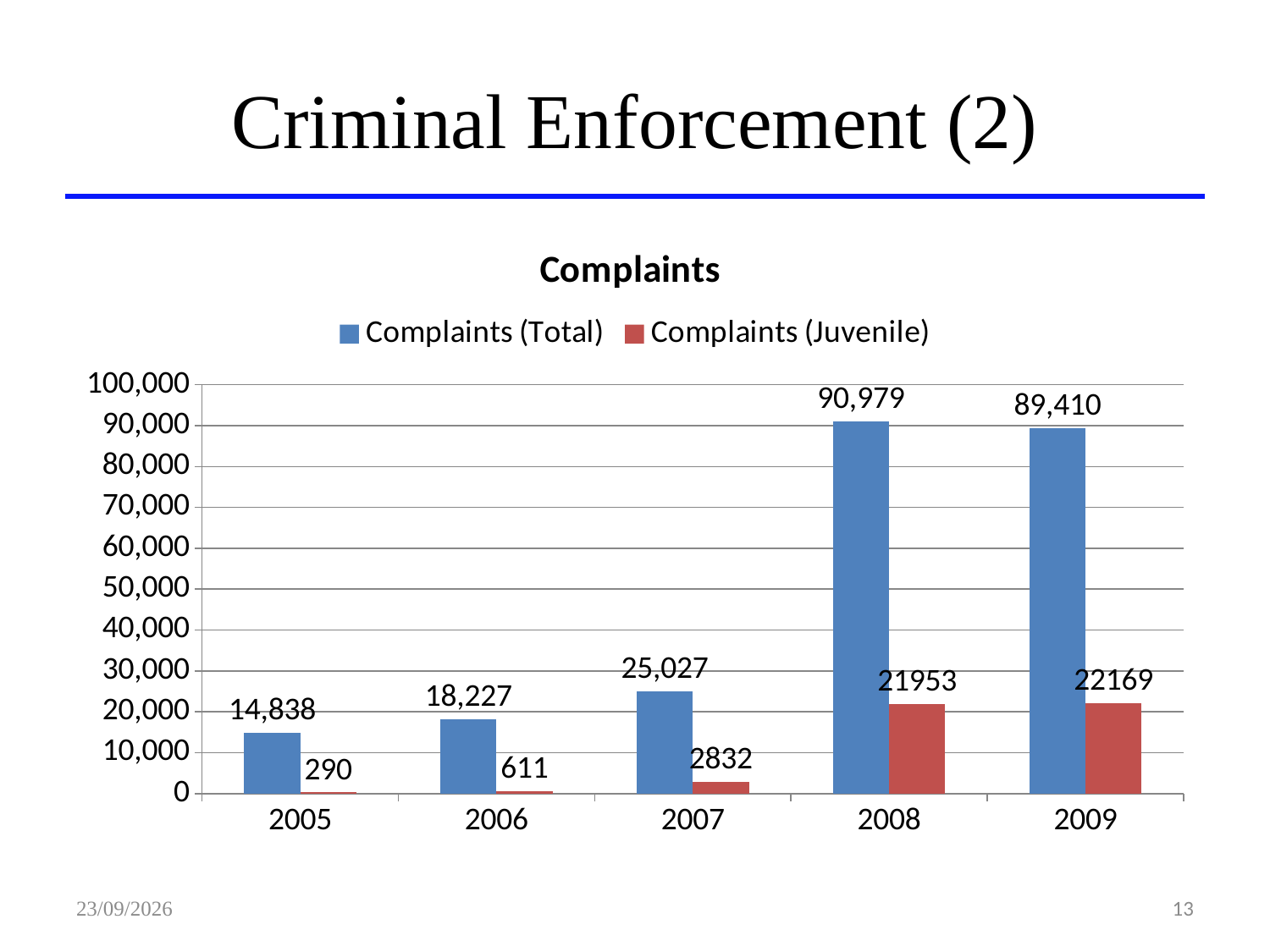
What is the value of Complaints (Total) for 2005? 14,838 What kind of chart is shown on the slide? bar chart Which is larger: Complaints (Total) in 2007 or Complaints (Juvenile) in 2009? Complaints (Total) in 2007 What is the value of Complaints (Juvenile) for 2007? 2832 Is the value for Complaints (Total) in 2006 greater or less than 20,000? less What is the difference between Complaints (Juvenile) in 2006 and 2005? 321 What is the difference between Complaints (Total) in 2008 and 2009? 1,569 How many years are shown on the x axis? 5 Which year has the highest value for Complaints (Total)? 2008 Which year has the lowest value for Complaints (Juvenile)? 2005 How many series does the legend list? 2 What is the value of Complaints (Total) for 2008? 90,979